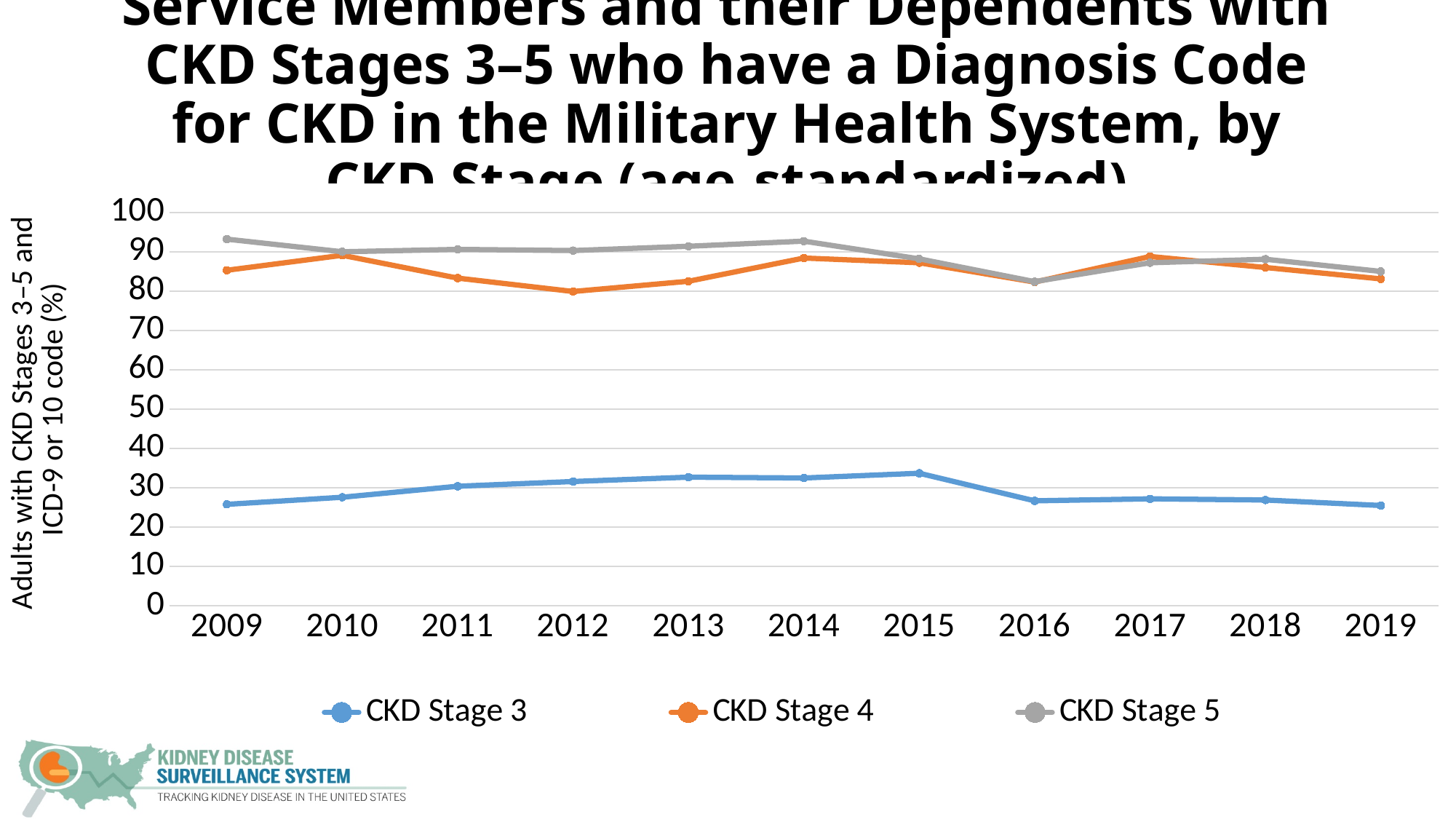
How many years are shown on the x axis? 11 Which is larger in 2009, the value for CKD Stage 4 or CKD Stage 5? CKD Stage 5 What colour is the CKD Stage 4 line? Orange Is the value for CKD Stage 5 in 2009 greater or less than 90? greater Does the CKD Stage 3 line rise or fall from 2009 to 2015? Rise Is the value for CKD Stage 3 in 2009 greater or less than 30? less Is the value for CKD Stage 4 in 2012 greater or less than 90? less In which year is the CKD Stage 5 value lowest? 2016 Which series has the lowest values across all years? CKD Stage 3 How many series does the legend list? 3 What kind of chart is shown on the slide? Line chart